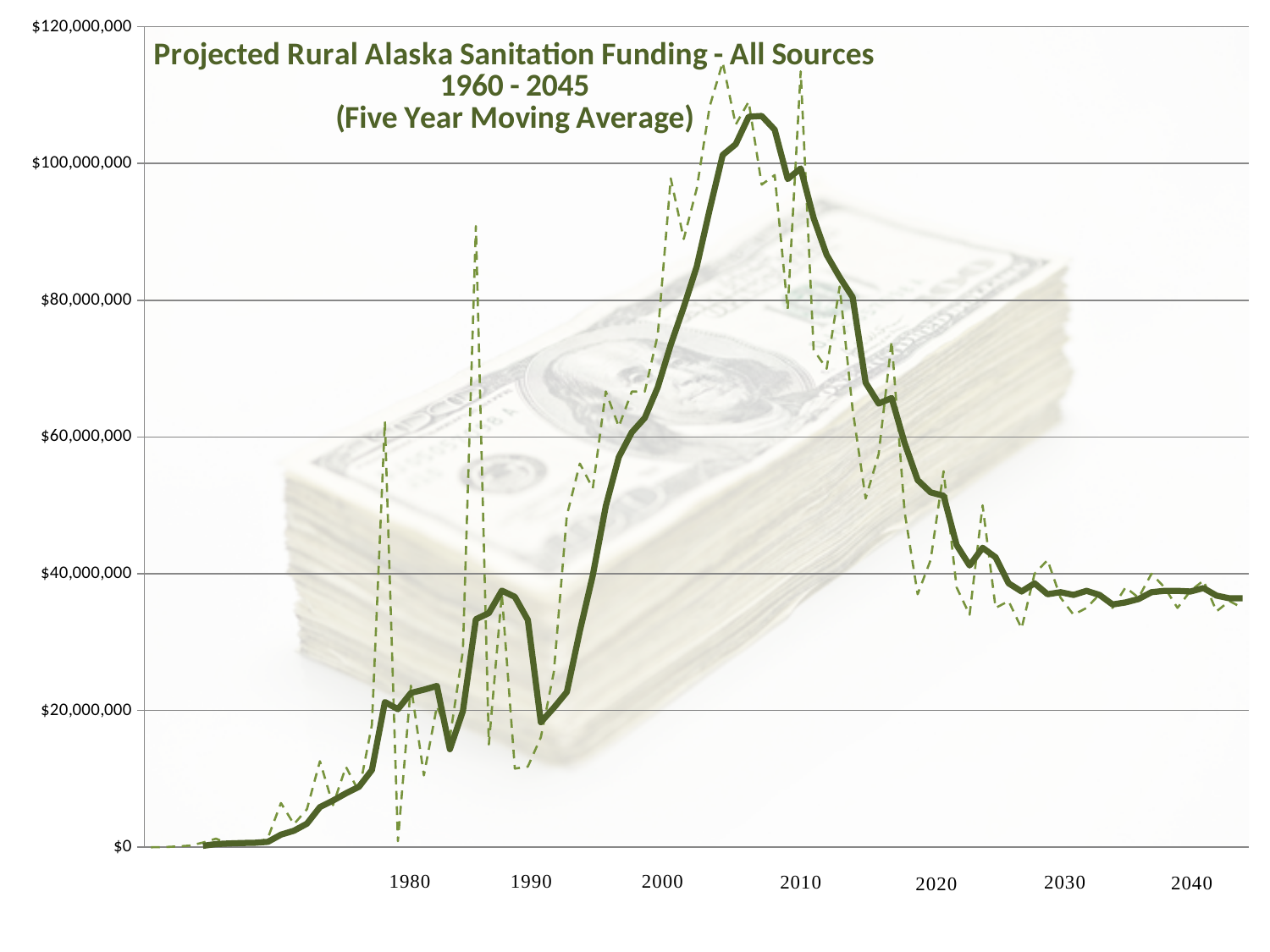
Is the value of the solid five-year moving average line at 1980 greater or less than $40,000,000? less What is the title of the chart? Projected Rural Alaska Sanitation Funding - All Sources 1960 - 2045 (Five Year Moving Average) How many lines are plotted on the chart? 2 What is the highest value shown on the vertical axis? $120,000,000 Is the value of the solid five-year moving average line at 2010 greater or less than $80,000,000? greater Does the solid five-year moving average line rise or fall between 1992 and 2005? rise Does the solid five-year moving average line rise or fall between 2010 and 2020? fall Is the value of the solid five-year moving average line at 2020 greater or less than $40,000,000? greater What kind of chart is shown on the slide? Line chart Which is larger on the solid five-year moving average line, the value at 2000 or the value at 2030? 2000